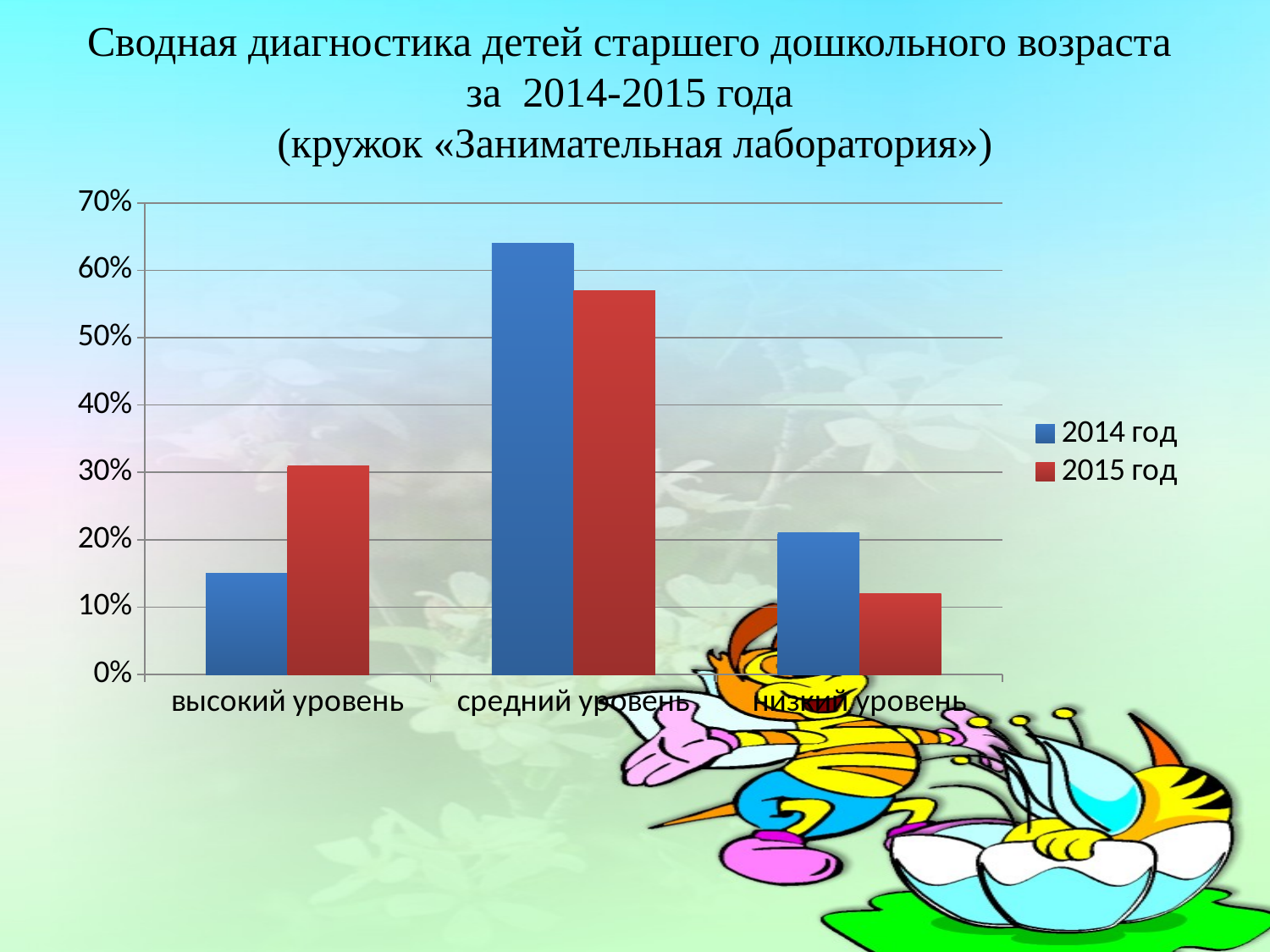
Is the value for 2014 год at средний уровень greater or less than 60%? greater Which category has the lowest value for 2015 год? низкий уровень How many categories are shown on the x axis? 3 Which category has the highest value for 2014 год? средний уровень Which category has the lowest value for 2014 год? высокий уровень Which colour represents 2015 год in the legend? red For средний уровень, which series is larger, 2014 год or 2015 год? 2014 год For высокий уровень, which series is larger, 2014 год or 2015 год? 2015 год How many series does the legend list? 2 Is the value for 2015 год at низкий уровень greater or less than 20%? less What kind of chart is shown on the slide? bar chart